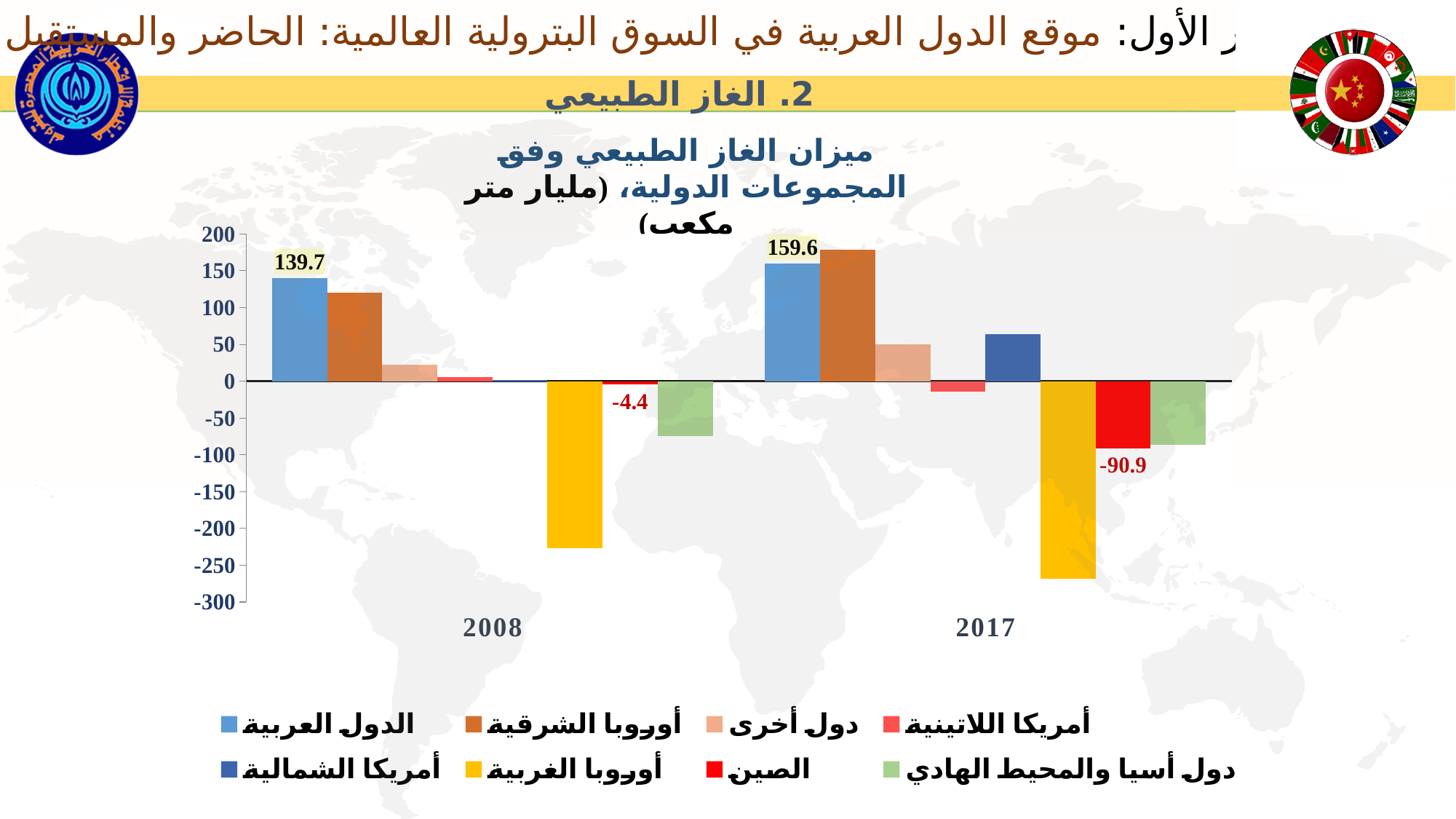
What is the value for الصين in 2017? -90.9 What is the value for الصين in 2008? -4.4 Which series has the lowest value in 2017? أوروبا الغربية How many year categories are shown on the x axis? 2 What kind of chart is shown on the slide? bar chart How many series does the legend list? 8 By how much did the value for الدول العربية increase from 2008 to 2017? 19.9 Is the value for أوروبا الغربية in 2008 greater or less than -200? less What is the value for الدول العربية in 2008? 139.7 Which series has the highest value in 2008? الدول العربية Which year has the larger value for الدول العربية, 2008 or 2017? 2017 What is the value for الدول العربية in 2017? 159.6